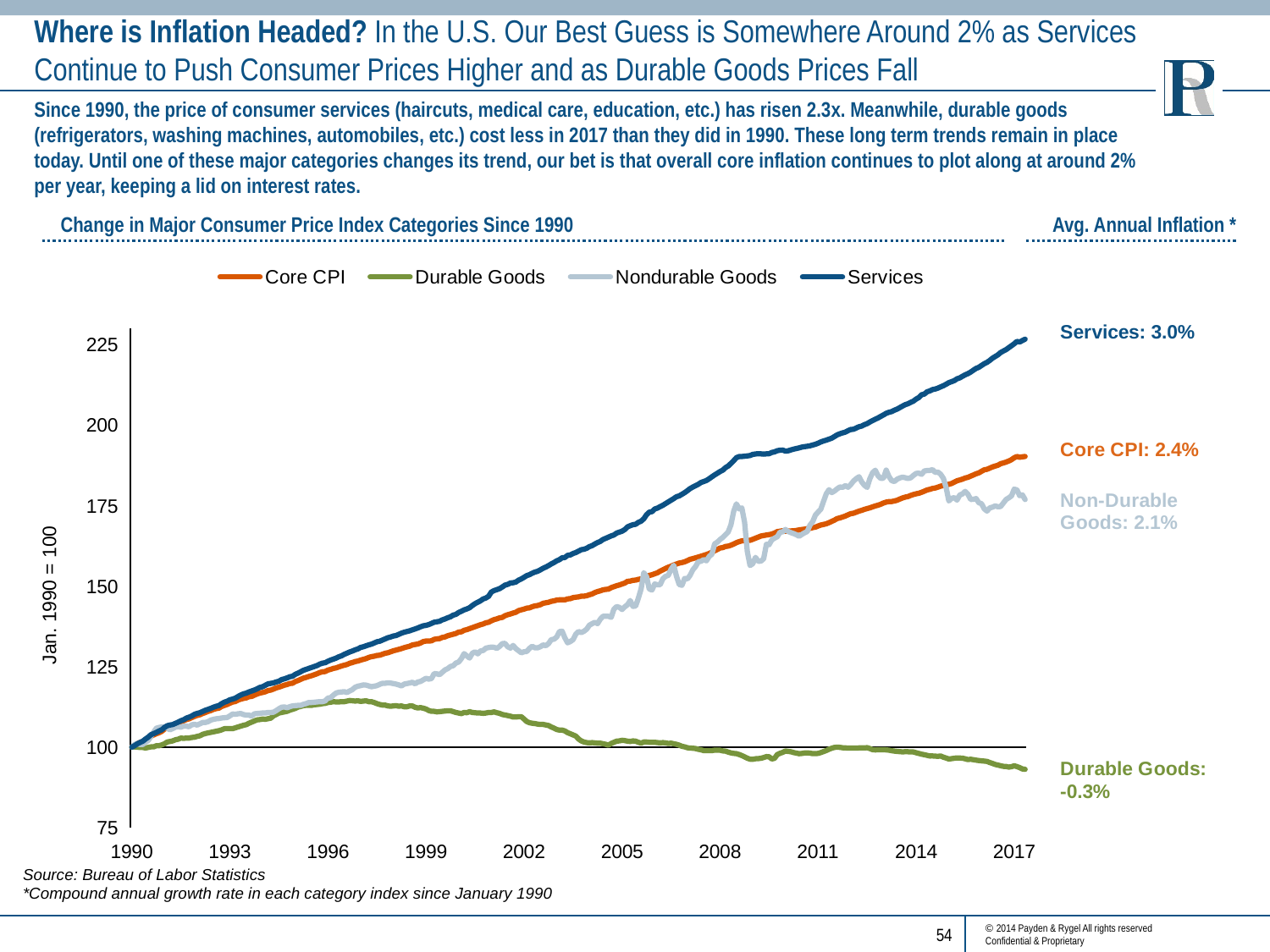
Is the Durable Goods index value in 2017 greater or less than 100? less Is the Services index value in 2017 greater or less than 200? greater What is the average annual inflation shown for Durable Goods? -0.3% What is the average annual inflation shown for Services? 3.0% What is the average annual inflation shown for Core CPI? 2.4% How many series does the chart legend list? 4 What is the difference between the average annual inflation for Services and for Core CPI? 0.6 percentage points Which category has the lowest average annual inflation since 1990? Durable Goods Which category has the highest average annual inflation since 1990? Services Does the Durable Goods line rise or fall between 1997 and 2017? Fall What is the average annual inflation shown for Non-Durable Goods? 2.1% What kind of chart is shown on the slide? Line chart